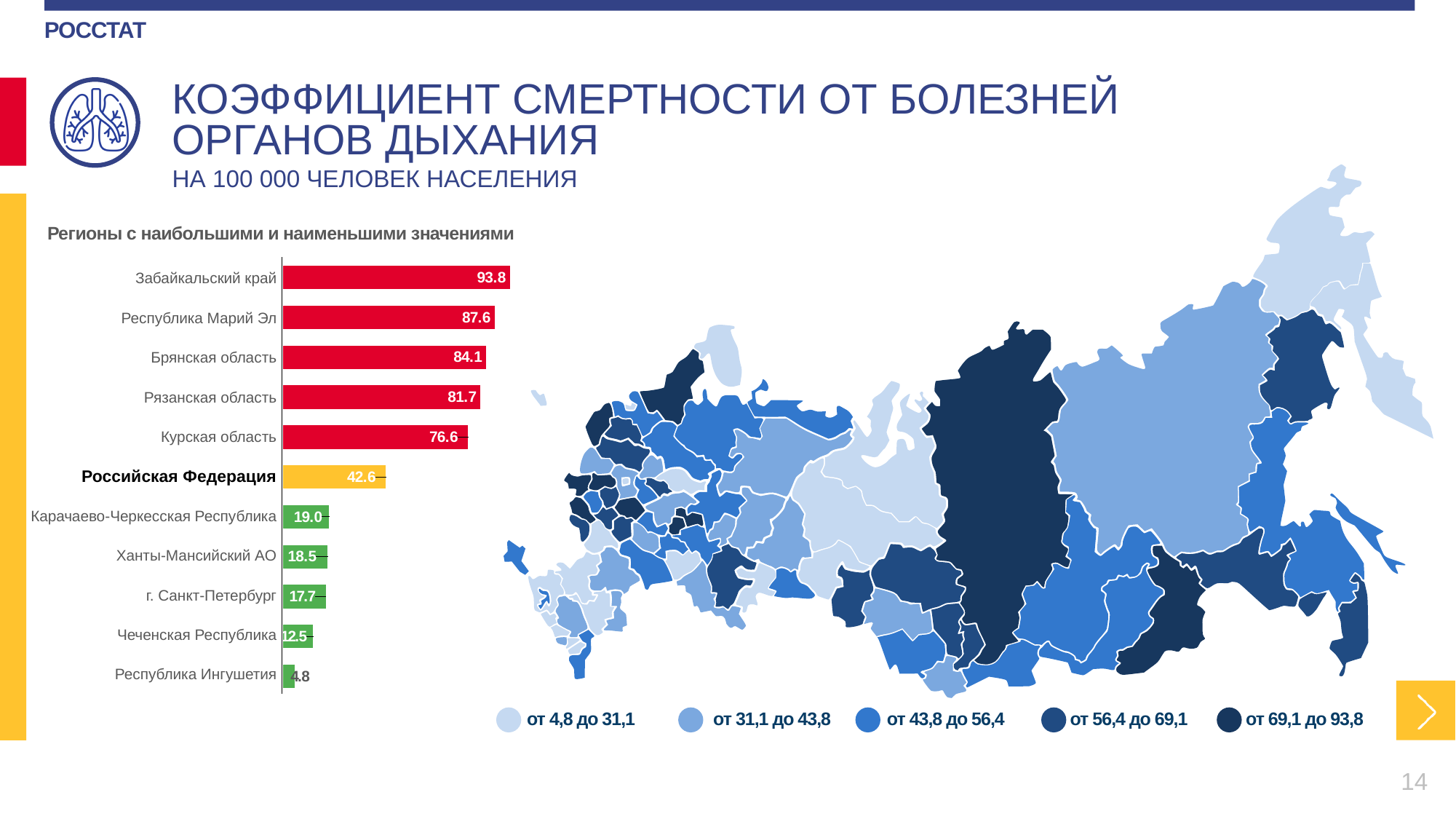
In the bar chart, what is the value for Российская Федерация? 42.6 What type of chart is used to show the regions with the highest and lowest values? Bar chart In the bar chart, what is the difference between the values for Забайкальский край and Республика Марий Эл? 6.2 How many value ranges does the map legend list? 5 In the bar chart, which region has the highest value? Забайкальский край In the bar chart, what is the value for Забайкальский край? 93.8 In the bar chart, what is the difference between the values for Курская область and Российская Федерация? 34.0 In the bar chart, which region has the lowest value? Республика Ингушетия In the bar chart, which is larger: the value for Брянская область or Рязанская область? Брянская область How many regions (bars) are shown in the bar chart? 11 In the bar chart, what is the value for г. Санкт-Петербург? 17.7 In the bar chart, which is larger: the value for Чеченская Республика or Ханты-Мансийский АО? Ханты-Мансийский АО